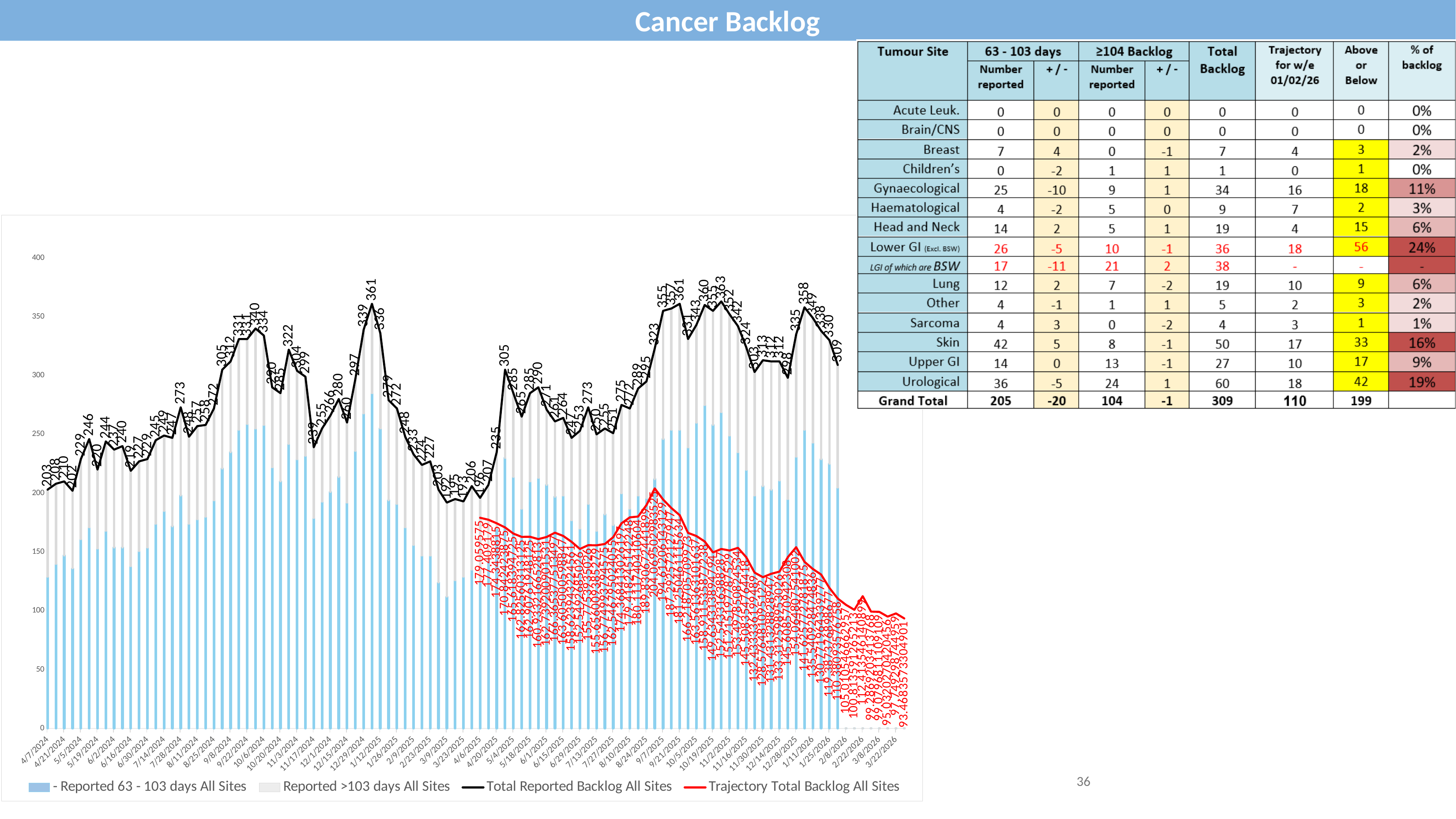
Is the Total Reported Backlog value at 4/7/2024 greater or less than 250? less What is the difference between the peak Total Reported Backlog value of 361 and the starting value of 203? 158 What kind of chart is shown on the slide? Combined bar and line chart What is the title of the slide containing the chart? Cancer Backlog What colour is the Trajectory Total Backlog All Sites line? Red What is the first value labelled on the Total Reported Backlog All Sites line, at 4/7/2024? 203 Is the Trajectory Total Backlog value at 3/22/2026 greater or less than 150? less What is the highest value labelled on the Total Reported Backlog All Sites line? 363 Which is larger on the Total Reported Backlog line: the value labelled 322 around 11/3/2024 or the value labelled 273 around 7/28/2024? 322 How many series does the chart legend list? 4 Does the Trajectory Total Backlog All Sites line generally rise or fall from 4/20/2025 to 3/22/2026? Fall What is the last value labelled on the Total Reported Backlog All Sites line? 309